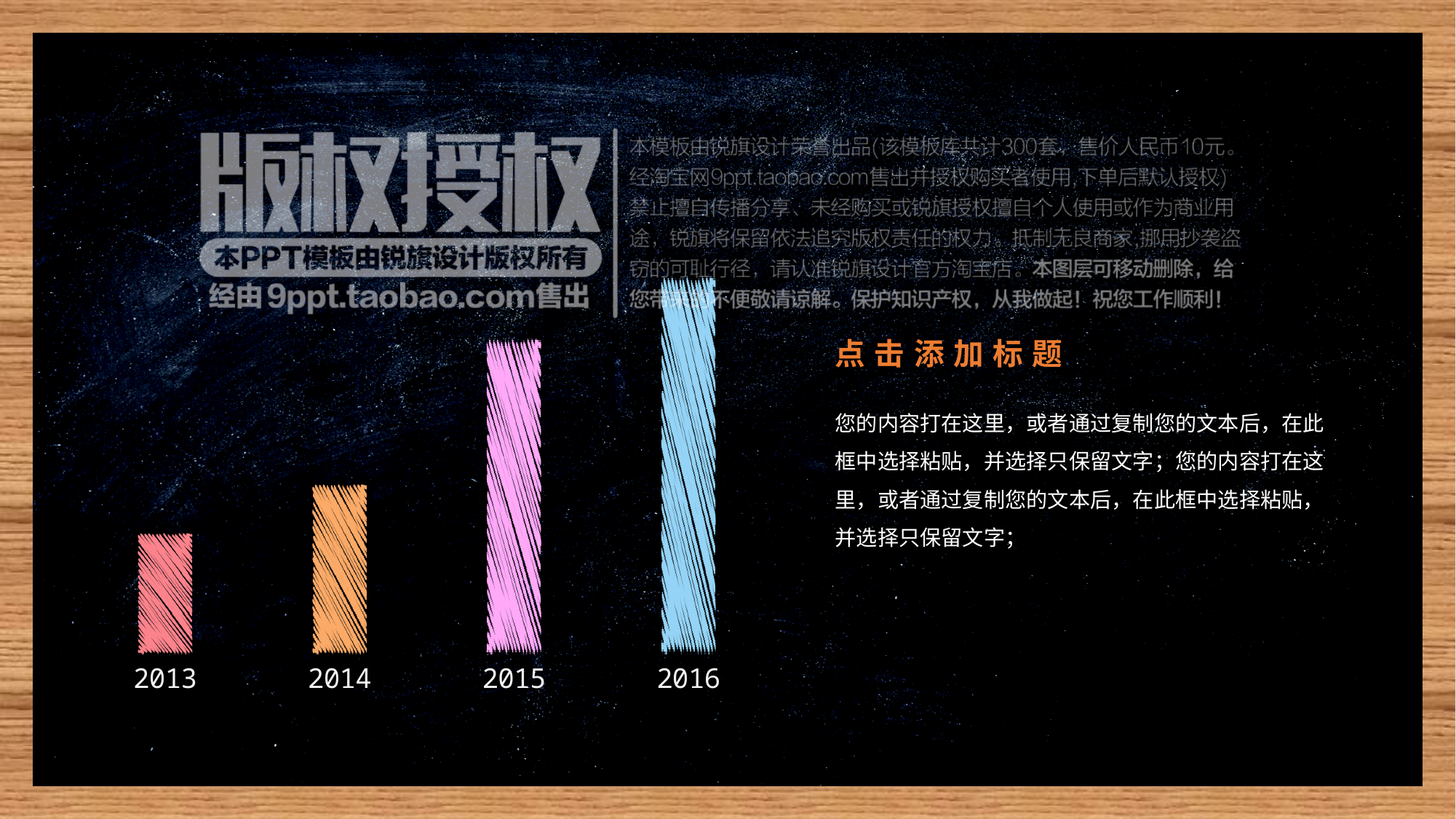
What is the first year shown on the x axis? 2013 How many bars does the chart have? 4 Which bar is taller, 2014 or 2015? 2015 Which year has the shortest bar? 2013 Do the bar heights rise or fall from 2013 to 2016? rise Which year has the tallest bar? 2016 What colour is the bar for 2016? light blue Which bar is taller, 2013 or 2014? 2014 What kind of chart is shown on the slide? bar chart